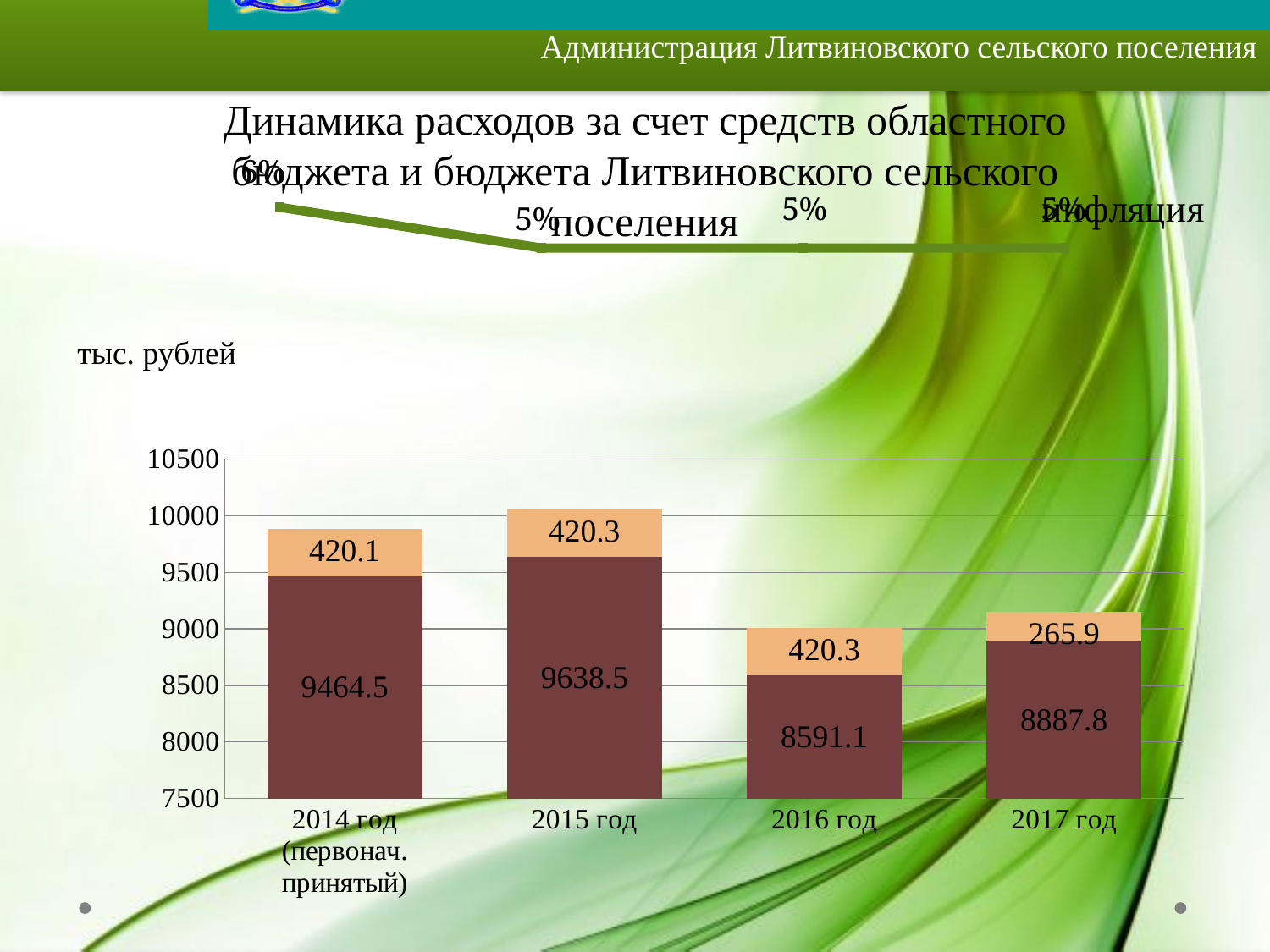
What is the total of the stacked bar for 2017 год? 9153.7 Which year has the highest value in the dark lower segment? 2015 год What is the value of the orange upper segment for 2017 год? 265.9 Is the total height of the stacked bar for 2015 год greater or less than 10000? greater Which year has the smallest orange upper segment? 2017 год What is the value of the dark lower segment for 2014 год (первонач. принятый)? 9464.5 What unit label is shown above the chart's vertical axis? тыс. рублей What is the value of the dark lower segment for 2016 год? 8591.1 How many year categories are shown on the x axis of the bar chart? 4 What type of chart is used to show the expenditure dynamics on this slide? stacked bar chart Which year has the lowest value in the dark lower segment? 2016 год What is the difference between the dark lower segment values for 2015 год and 2014 год (первонач. принятый)? 174.0